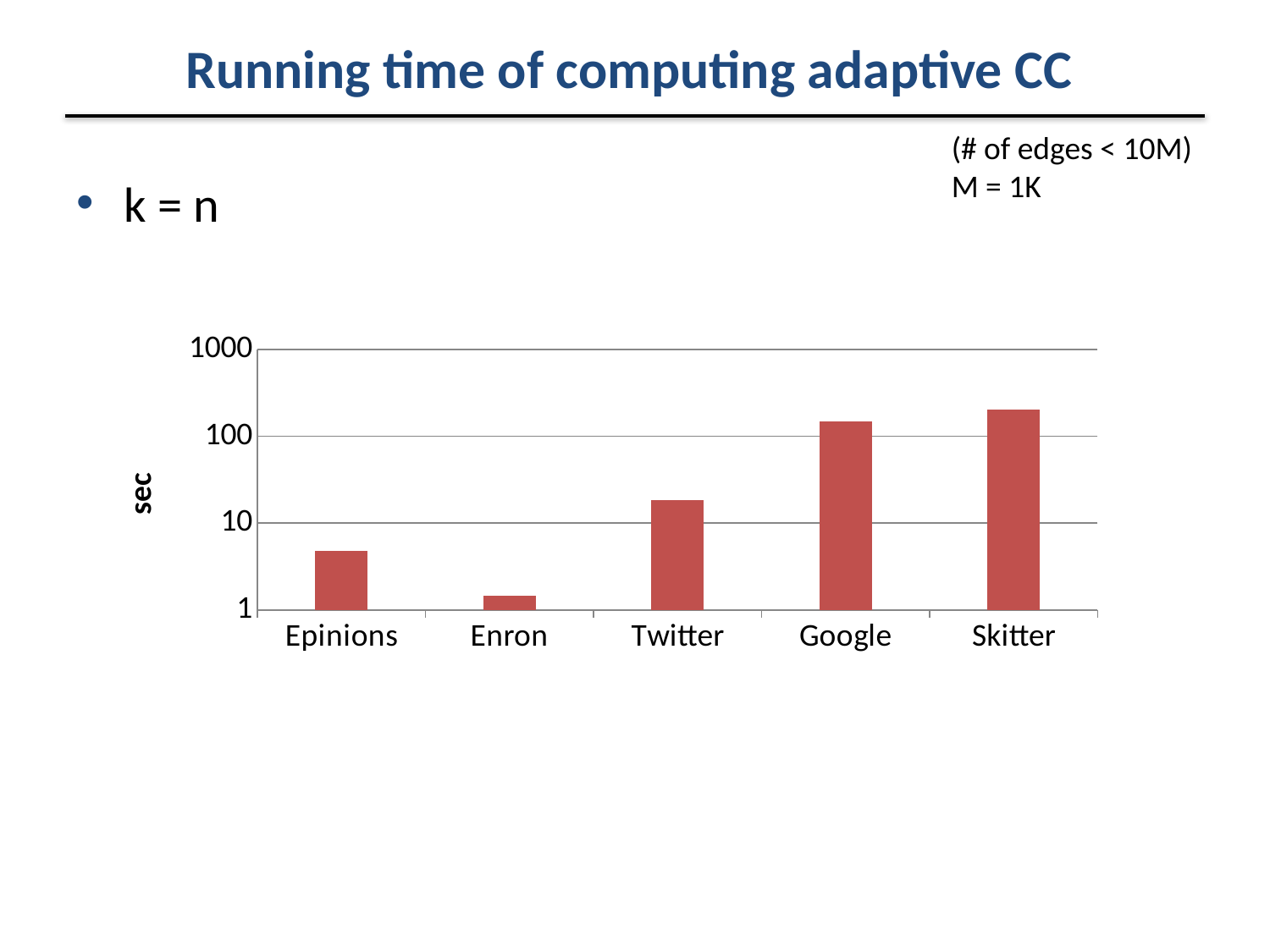
Is the value for Google greater or less than 100? greater Which has a larger running time, Google or Twitter? Google Is the value for Epinions greater or less than 10? less Which category has the lowest running time in the chart? Enron How many categories are shown on the x axis of the chart? 5 Which has a larger running time, Epinions or Enron? Epinions What kind of chart is shown on the slide? bar chart Is the value for Skitter greater or less than 1000? less What is the title of the slide containing the chart? Running time of computing adaptive CC What is the label on the y axis of the chart? sec Which category has the highest running time in the chart? Skitter